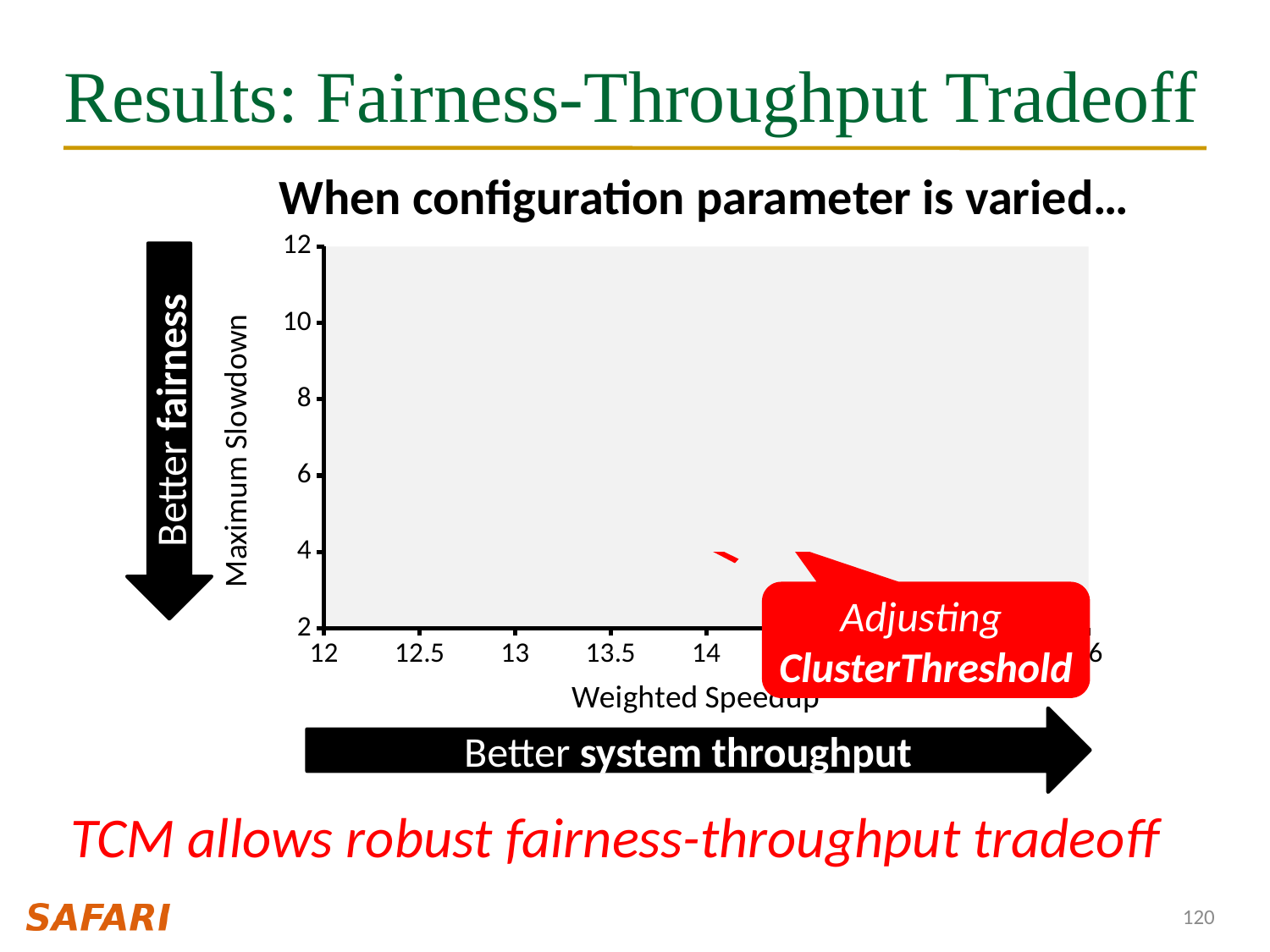
Is the Weighted Speedup of the visible red data point greater or less than 15? less What is the label of the y axis of the chart? Maximum Slowdown Is the Maximum Slowdown of the visible red data point greater or less than 6? less What is the label of the x axis of the chart? Weighted Speedup What kind of chart is shown on the slide? scatter plot Is the Maximum Slowdown of the visible red data point greater or less than 2? greater